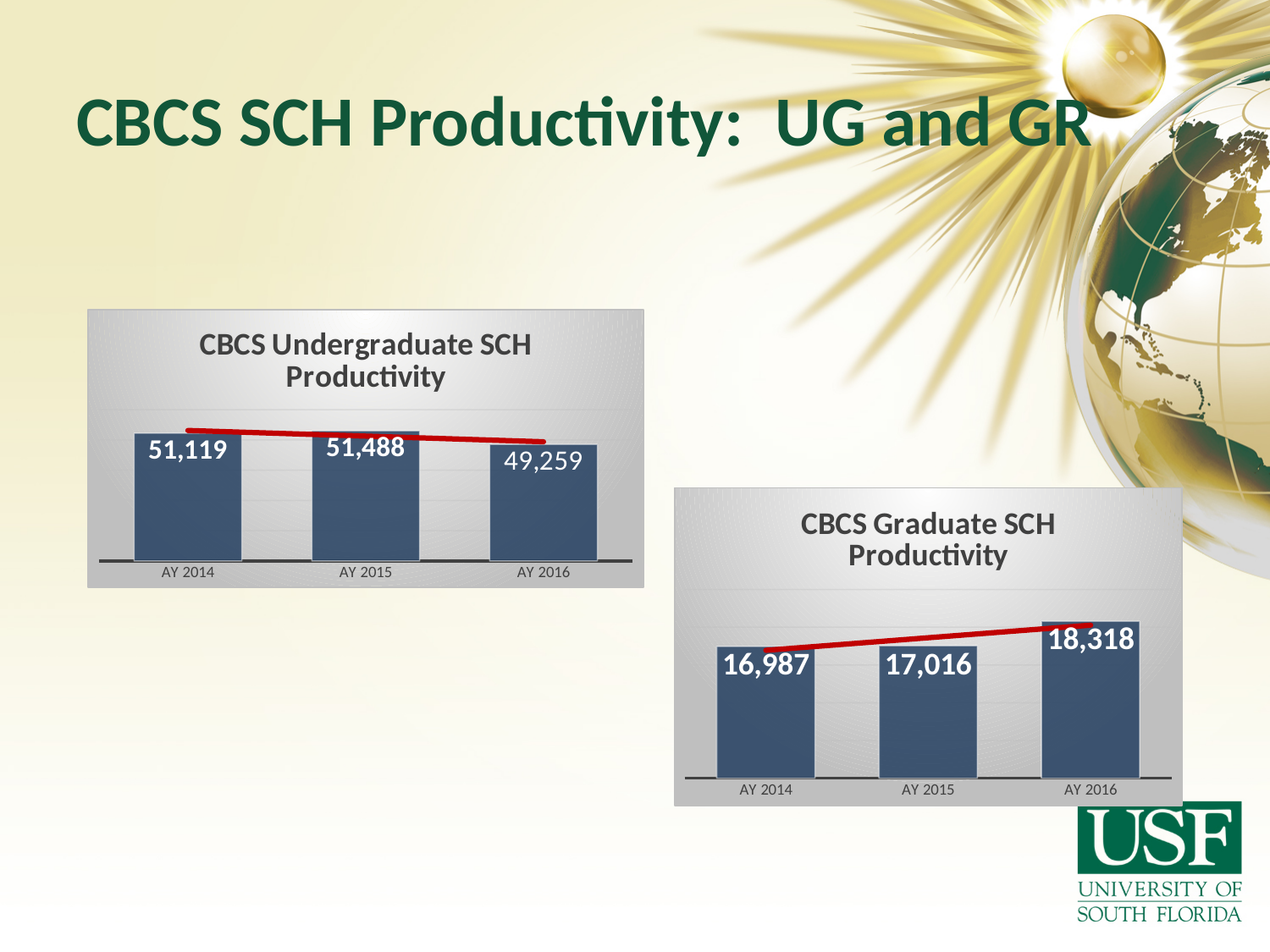
In the CBCS Undergraduate SCH Productivity chart, what is the value for AY 2016? 49,259 In the CBCS Undergraduate SCH Productivity chart, what is the value for AY 2014? 51,119 How many academic years are shown in the CBCS Graduate SCH Productivity chart? 3 In the CBCS Graduate SCH Productivity chart, do the values rise or fall from AY 2014 to AY 2016? Rise In the CBCS Undergraduate SCH Productivity chart, what is the difference between the AY 2015 and AY 2016 values? 2,229 In the CBCS Graduate SCH Productivity chart, what is the difference between the AY 2016 and AY 2014 values? 1,331 In the CBCS Graduate SCH Productivity chart, what is the value for AY 2016? 18,318 In the CBCS Undergraduate SCH Productivity chart, which is larger, the value for AY 2014 or AY 2016? AY 2014 In the CBCS Graduate SCH Productivity chart, what is the value for AY 2015? 17,016 In the CBCS Graduate SCH Productivity chart, which academic year has the highest value? AY 2016 What type of chart is the CBCS Undergraduate SCH Productivity chart? Bar chart In the CBCS Undergraduate SCH Productivity chart, which academic year has the lowest value? AY 2016